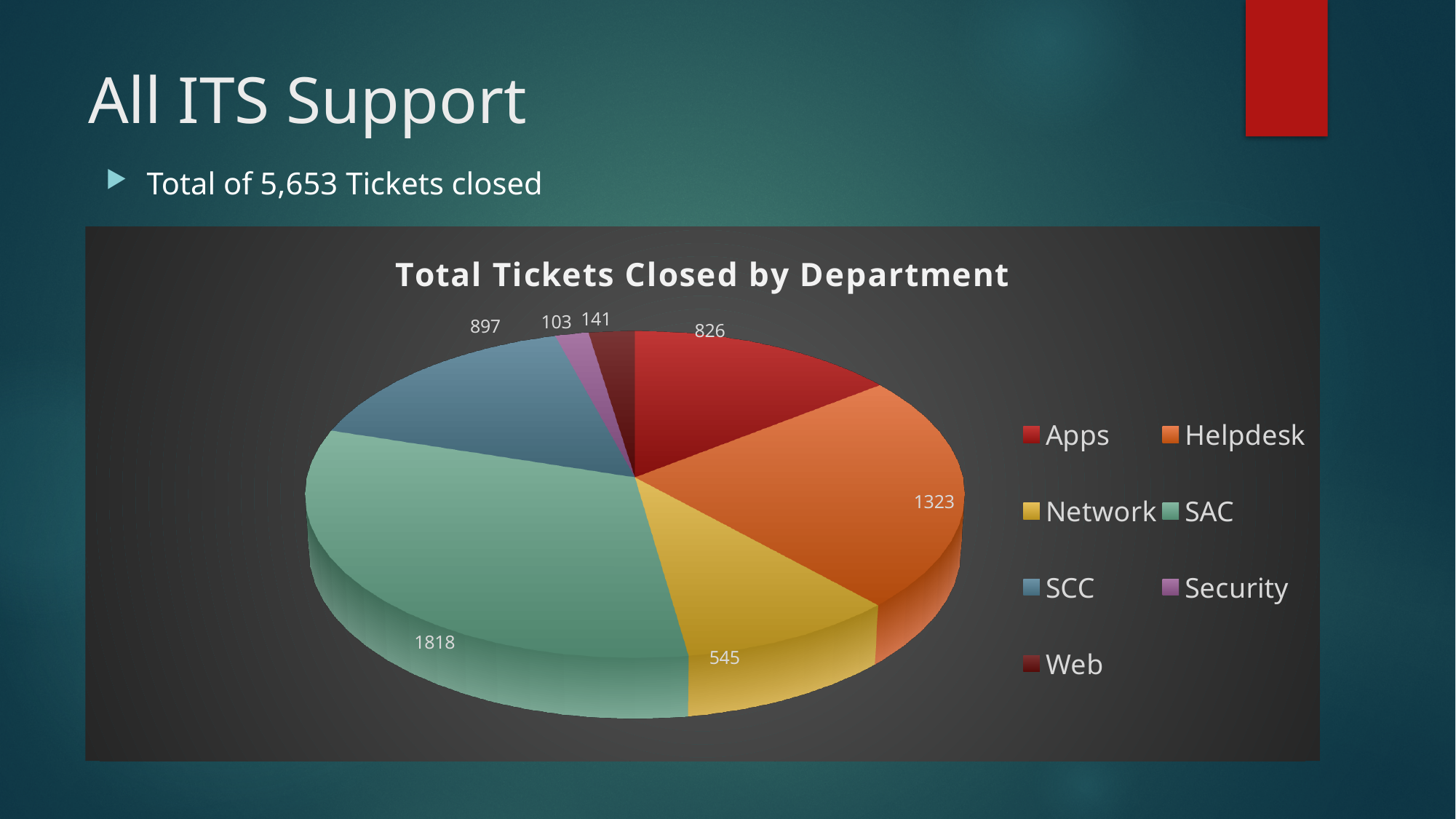
What is the difference between the Apps and Network values? 281 How many departments are shown in the pie chart? 7 What is the value shown for Security in the pie chart? 103 What is the difference between the SAC and Helpdesk values? 495 Which department has the smallest slice in the pie chart? Security What is the title of the chart? Total Tickets Closed by Department Which department has the largest slice in the pie chart? SAC How many tickets were closed by Helpdesk according to the chart? 1323 What is the value shown for Web in the pie chart? 141 What kind of chart is shown on the slide? Pie chart What is the value for SAC in the Total Tickets Closed by Department chart? 1818 Which is larger, the value for SCC or the value for Apps? SCC